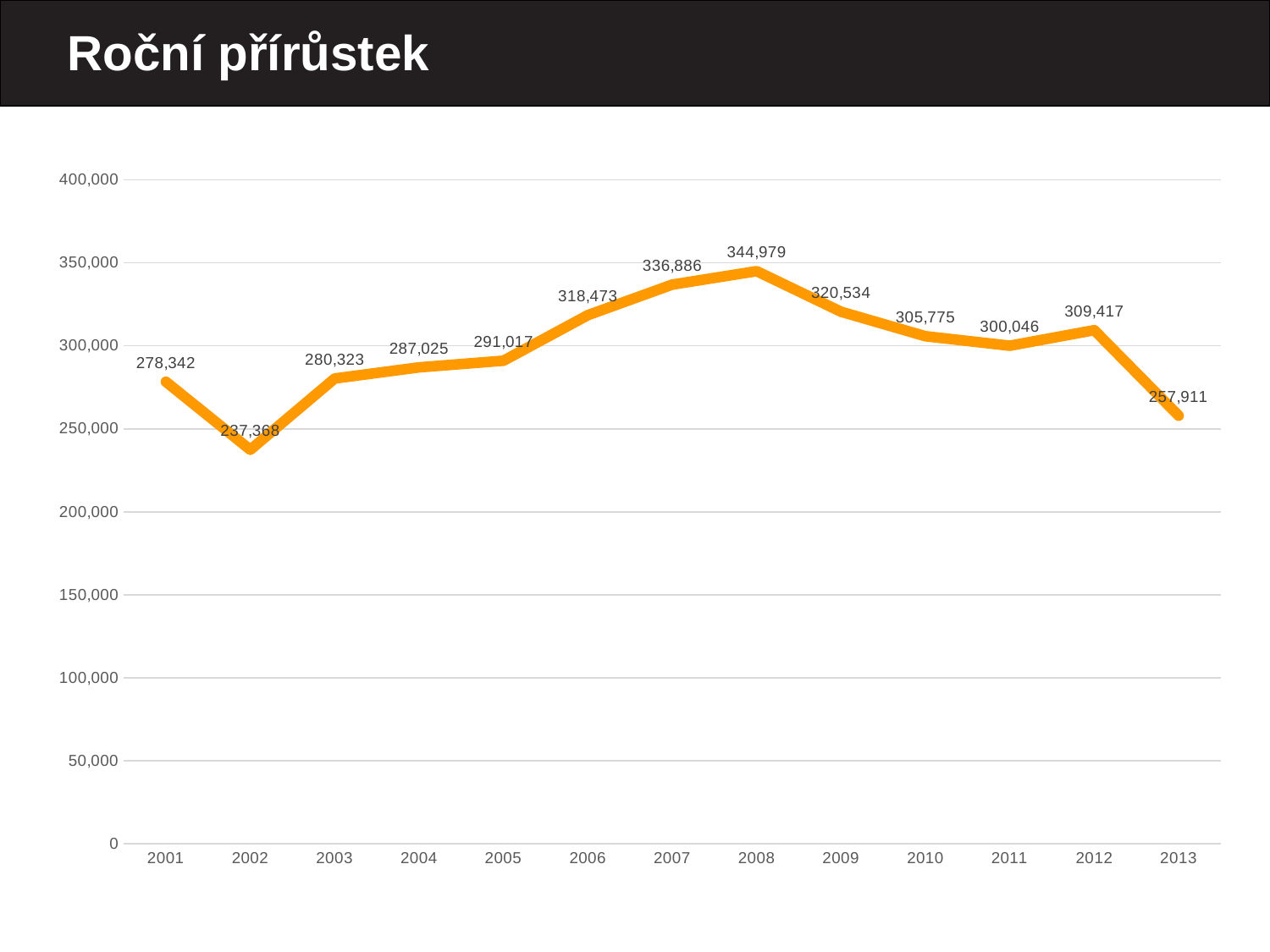
What is the title of the slide? Roční přírůstek Which year has the highest value? 2008 Is the value for 2007 greater or less than 300,000? greater Which year has the lowest value? 2002 Which is larger, the value for 2009 or the value for 2010? 2009 What is the value for 2013? 257,911 What is the difference between the values for 2012 and 2013? 51,506 What is the value for 2002? 237,368 What is the value for 2008? 344,979 What is the difference between the values for 2008 and 2002? 107,611 What kind of chart is shown on the slide? line chart How many years are plotted on the chart? 13